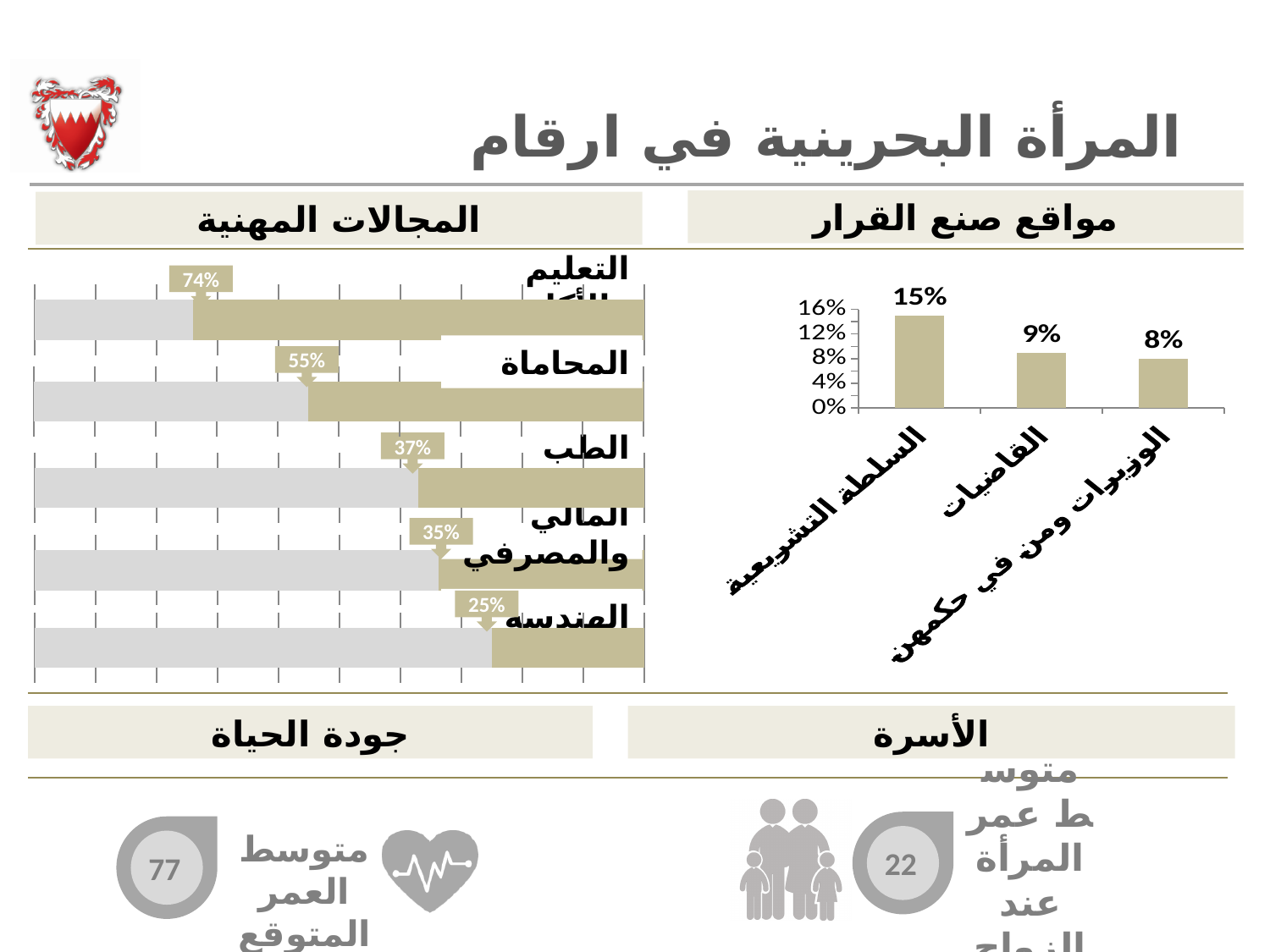
In the 'مواقع صنع القرار' chart, how many categories are shown? 3 In the 'المجالات المهنية' chart, what is the difference between التعليم and المحاماة? 19% In the 'المجالات المهنية' chart, which is larger, الطب or المالي والمصرفي? الطب In the 'مواقع صنع القرار' chart, which category has the lowest value? الوزيرات ومن في حكمهن In the 'المجالات المهنية' chart, which category has the highest value? التعليم In the 'مواقع صنع القرار' chart, what is the value for القاضيات? 9% In the 'المجالات المهنية' chart, what is the value for الهندسة? 25% In the 'مواقع صنع القرار' chart, what is the value for السلطة التشريعية? 15% In the 'المجالات المهنية' chart, how many categories are shown? 5 In the 'مواقع صنع القرار' chart, what kind of chart is used? bar chart In the 'المجالات المهنية' chart, what is the value for المحاماة? 55% In the 'مواقع صنع القرار' chart, what is the difference between السلطة التشريعية and الوزيرات ومن في حكمهن? 7%